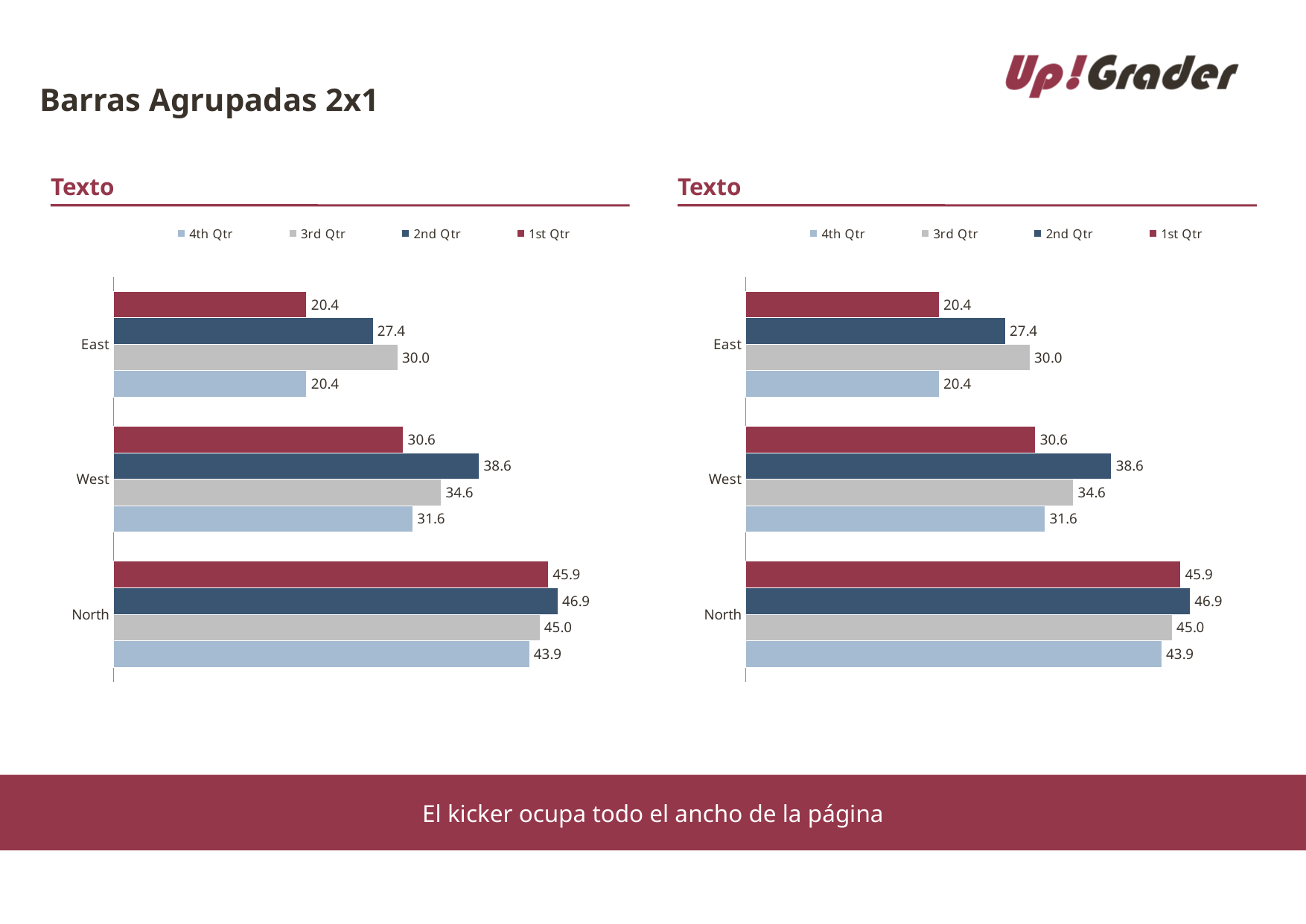
In the right chart, how many categories are shown on the vertical axis? 3 In the right chart, what is the value for North in the 4th Qtr series? 43.9 In the left chart, which category has the lowest value in the 4th Qtr series? East In the left chart, what is the value for West in the 3rd Qtr series? 34.6 In the left chart, what is the value for East in the 2nd Qtr series? 27.4 In the right chart, which category has the highest value in the 1st Qtr series? North What kind of chart is the right chart? Bar chart In the left chart, what is the difference between the North and East values in the 3rd Qtr series? 15.0 In the left chart, which is larger for East: the 3rd Qtr value or the 2nd Qtr value? 3rd Qtr In the right chart, which legend entry is shown in dark red? 1st Qtr In the left chart, how many series does the legend list? 4 In the right chart, what is the difference between the 2nd Qtr and 1st Qtr values for West? 8.0